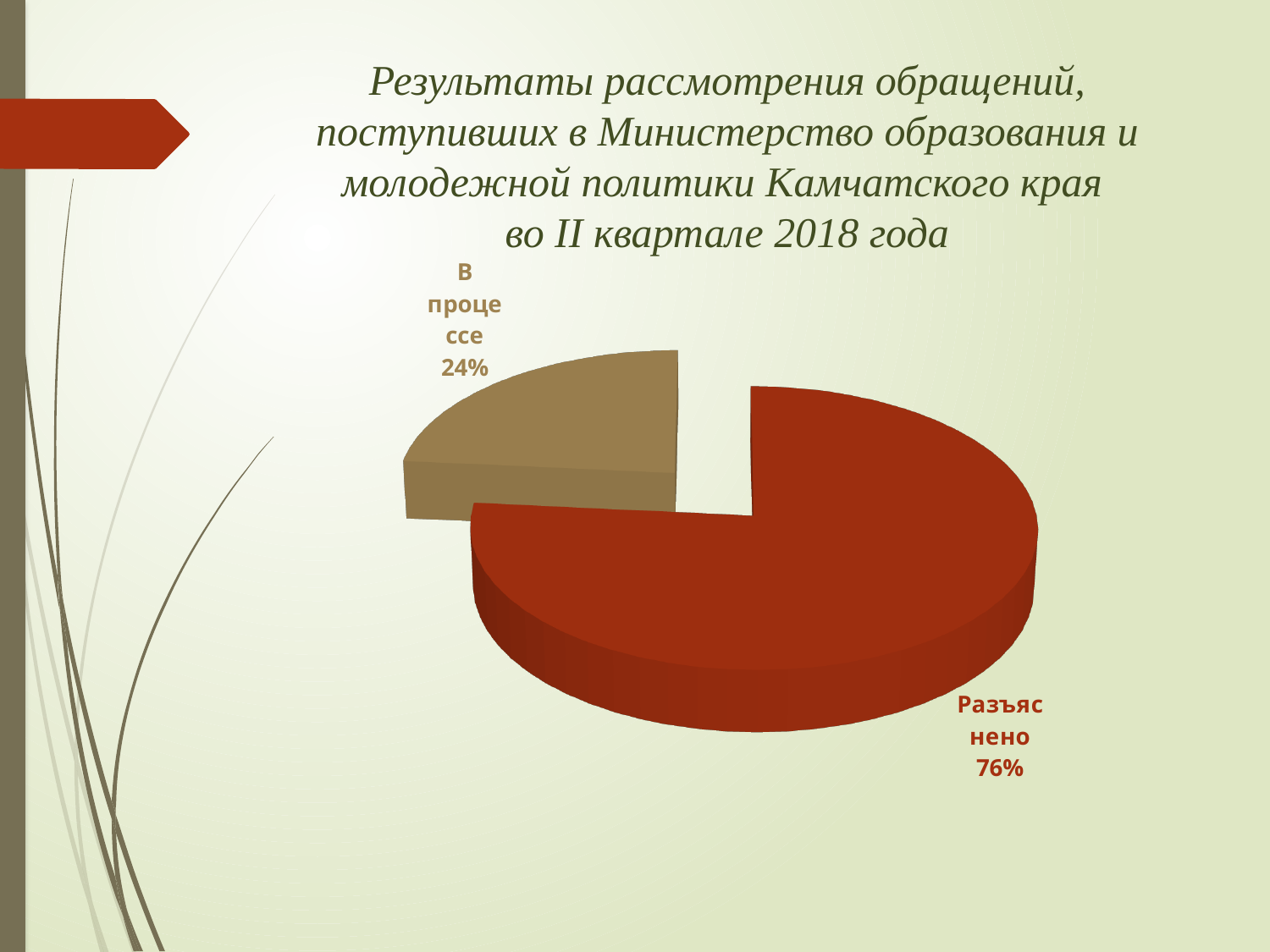
What kind of chart is shown on the slide? pie chart What is the difference in percentage points between the 'Разъяснено' and 'В процессе' slices? 52 Which slice of the pie is the largest? Разъяснено Which is larger, the 'Разъяснено' slice or the 'В процессе' slice? Разъяснено Which slice of the pie is the smallest? В процессе What share of the pie does the 'Разъяснено' slice represent? 76% What colour is the 'В процессе' slice? brown What colour is the 'Разъяснено' slice? red What share of the pie does the 'В процессе' slice represent? 24% How many slices does the pie chart have? 2